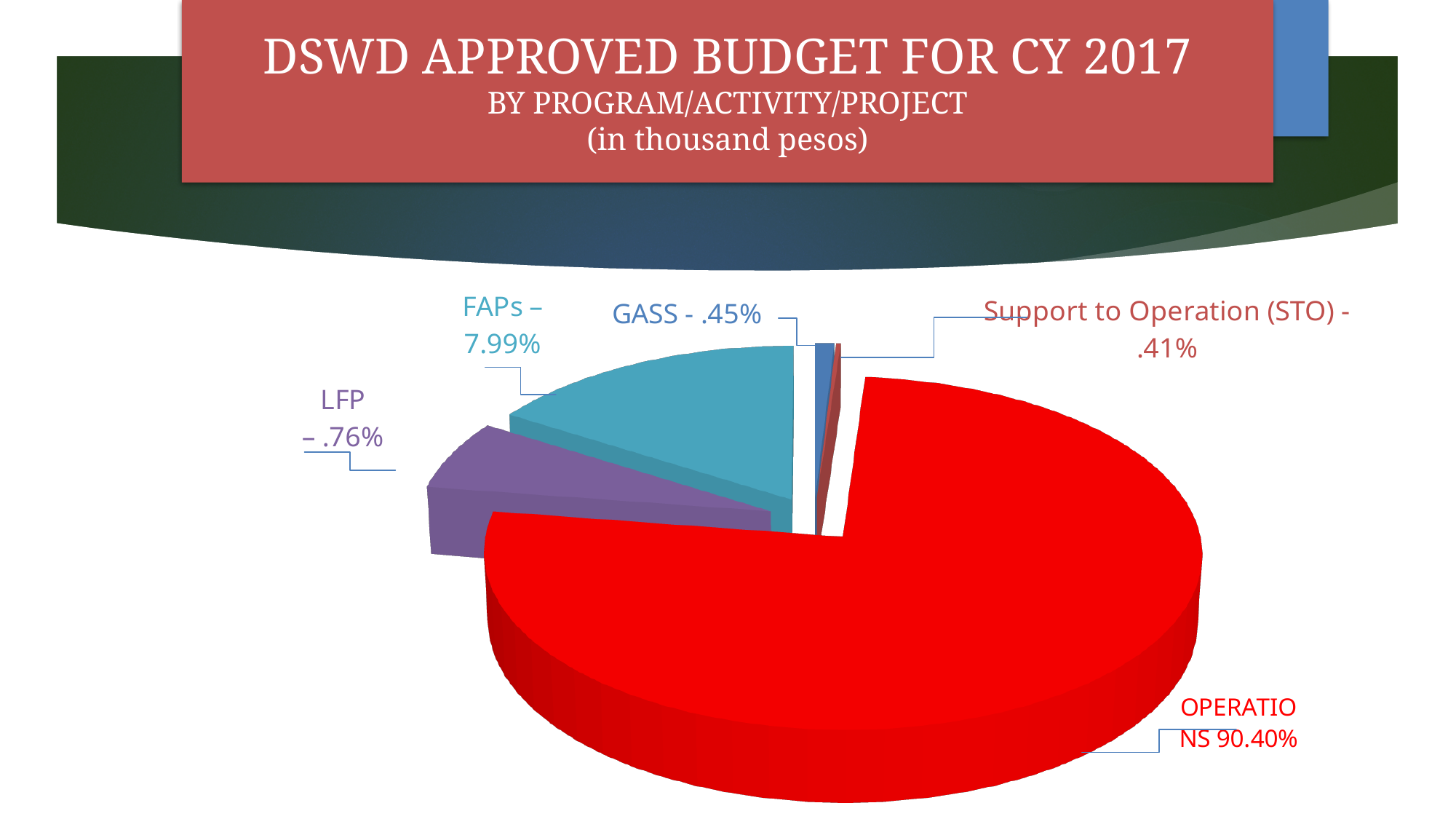
What share of the budget goes to LFP? .76% Which is larger, the share for FAPs or the share for LFP? FAPs What share of the budget goes to FAPs? 7.99% What share of the budget goes to GASS? .45% Which category has the largest share of the pie? OPERATIONS What is the title of the chart? DSWD APPROVED BUDGET FOR CY 2017 BY PROGRAM/ACTIVITY/PROJECT (in thousand pesos) How many slices does the pie chart have? 5 What share of the budget goes to Support to Operation (STO)? .41% Which category has the smallest share of the pie? Support to Operation (STO) What kind of chart is shown on the slide? pie chart What share of the budget goes to OPERATIONS? 90.40% What is the difference between the FAPs share and the LFP share? 7.23%